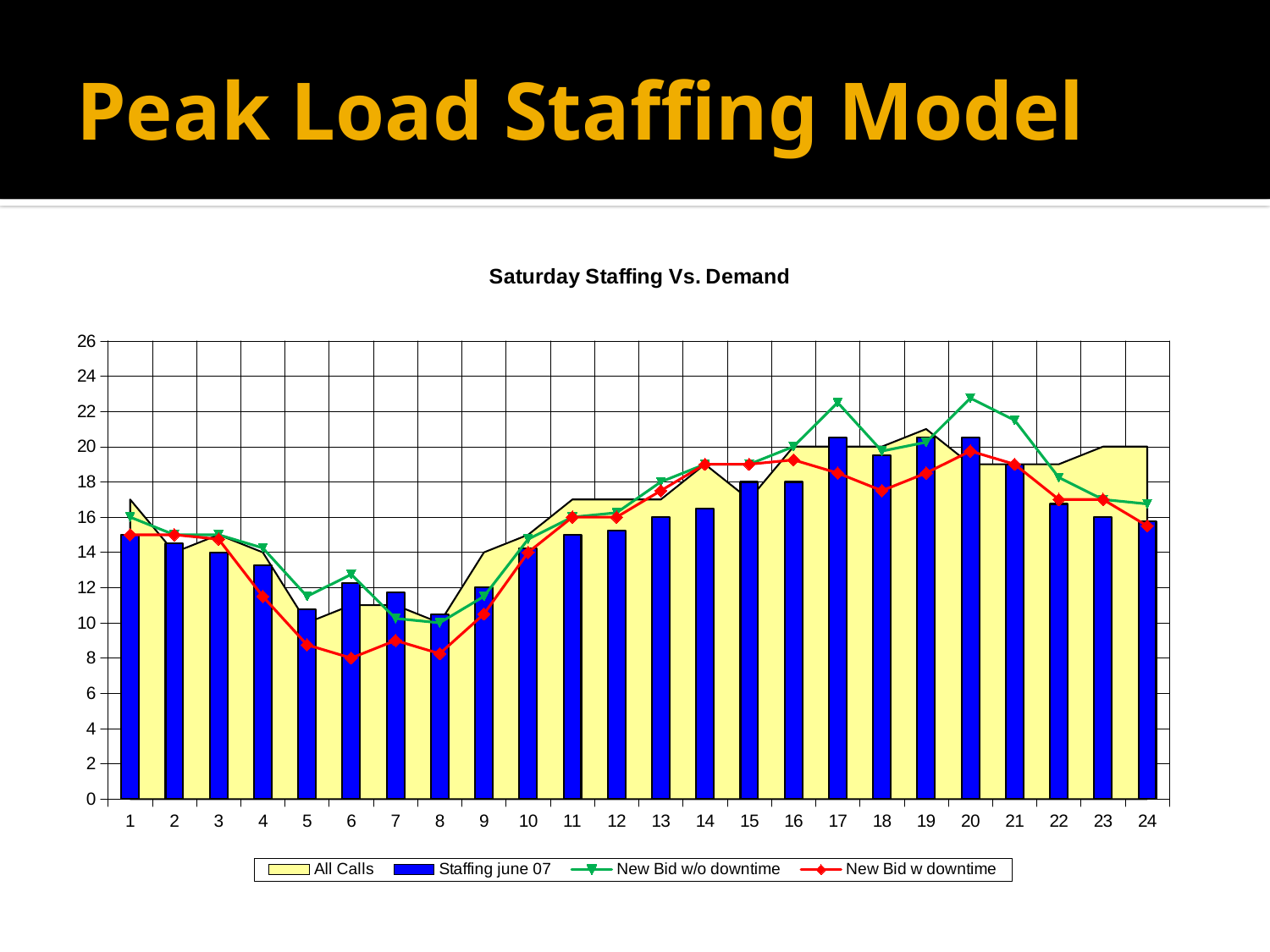
What colour is the New Bid w downtime line? red Is the New Bid w/o downtime value at hour 20 greater or less than 20? greater At hour 17, which is higher, New Bid w/o downtime or New Bid w downtime? New Bid w/o downtime Is the Staffing june 07 value at hour 5 greater or less than 12? less Which is larger, the Staffing june 07 value at hour 17 or at hour 8? hour 17 Is the New Bid w downtime value at hour 6 greater or less than 10? less Do the Staffing june 07 bars rise or fall from hour 1 to hour 5? fall What is the title of the chart? Saturday Staffing Vs. Demand Is the Staffing june 07 series drawn as bars or as a line? bars How many hour categories are shown on the x axis? 24 How many series does the chart legend list? 4